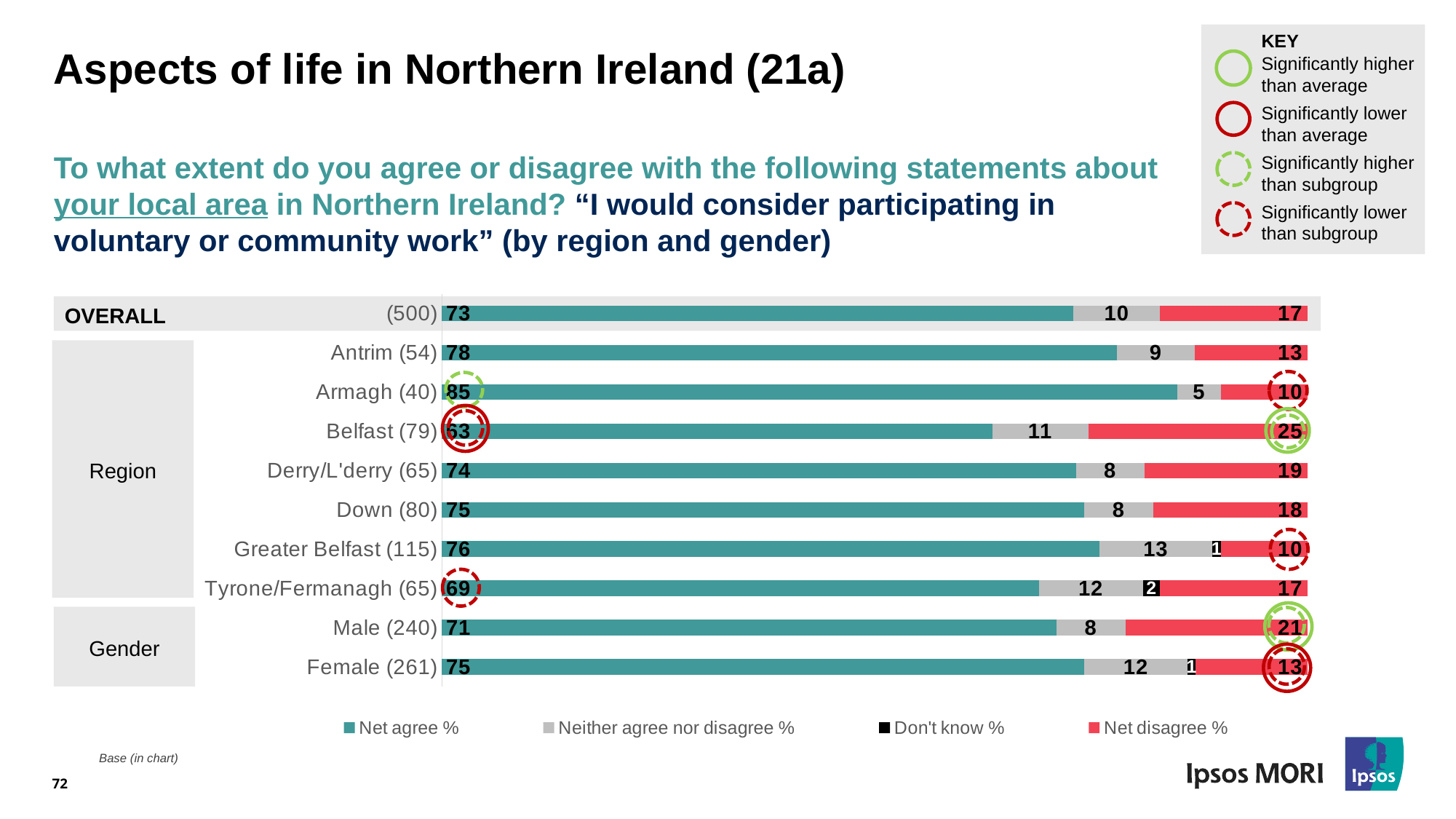
How many bars (categories) are shown in the chart? 10 What is the Don't know % for Tyrone/Fermanagh (65)? 2 Which category has the highest Net agree %? Armagh (40) What kind of chart is shown on the slide? Stacked bar chart Which has a higher Net disagree %, Derry/L'derry (65) or Down (80)? Derry/L'derry (65) Which category has the lowest Net agree %? Belfast (79) How many series does the legend list? 4 What is the difference in Net agree % between Armagh (40) and Belfast (79)? 22 What is the Net disagree % for Male (240)? 21 Which category has the highest Net disagree %? Belfast (79) What is the Neither agree nor disagree % for Female (261)? 12 What is the Net agree % for Antrim (54)? 78